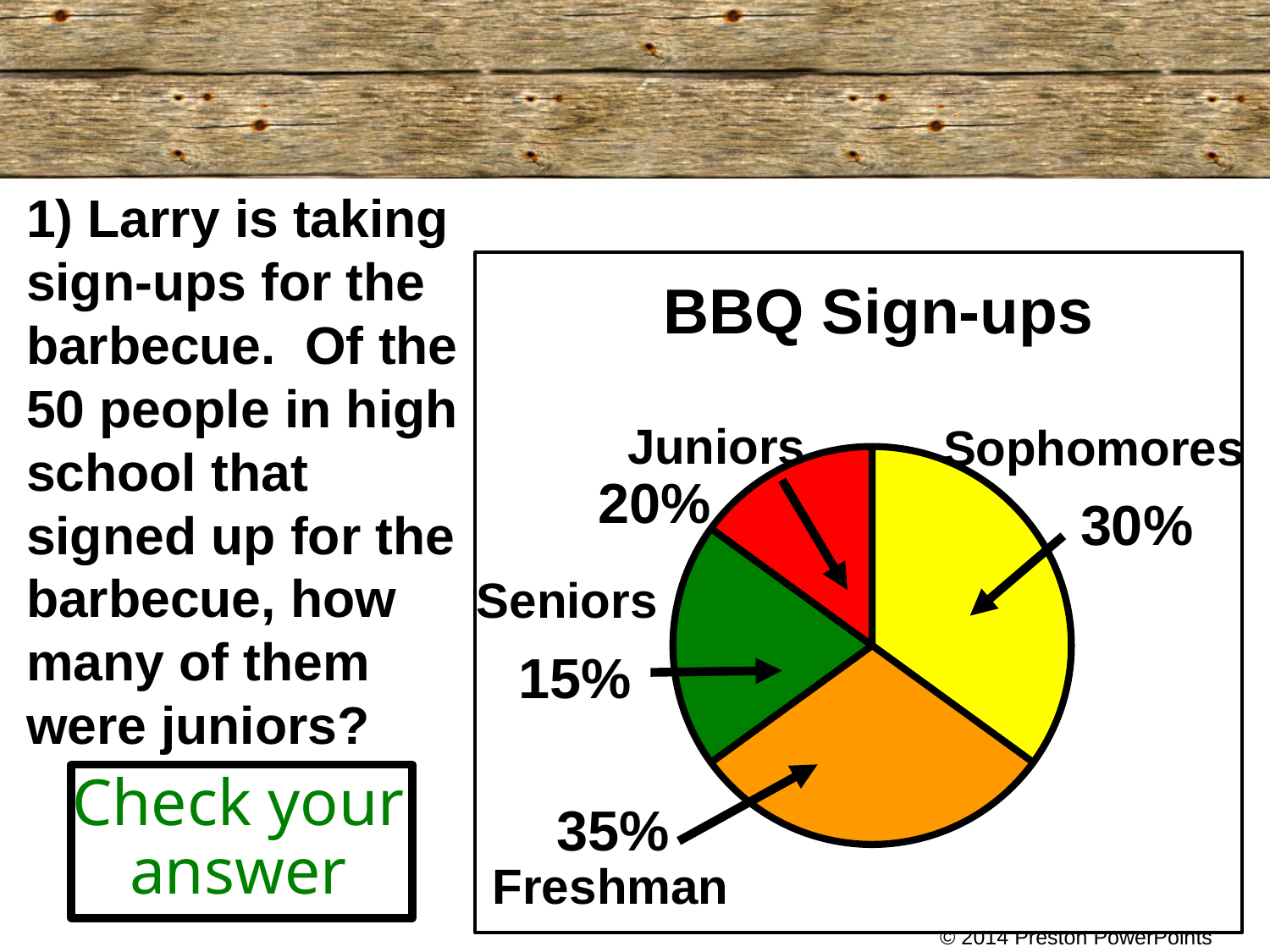
What percentage of BBQ sign-ups were Sophomores? 30% What is the difference in percentage points between the Freshman and Seniors slices? 20% What percentage of BBQ sign-ups were Seniors? 15% What kind of chart is shown on the slide? pie chart Which group has the smallest share of BBQ sign-ups? Seniors What is the title of the chart? BBQ Sign-ups What colour is the Seniors slice? green How many groups are shown in the pie chart? 4 Which group has the largest share of BBQ sign-ups? Freshman What percentage of BBQ sign-ups were Freshman? 35% What percentage of BBQ sign-ups were Juniors? 20% Which slice is larger, Sophomores or Juniors? Sophomores